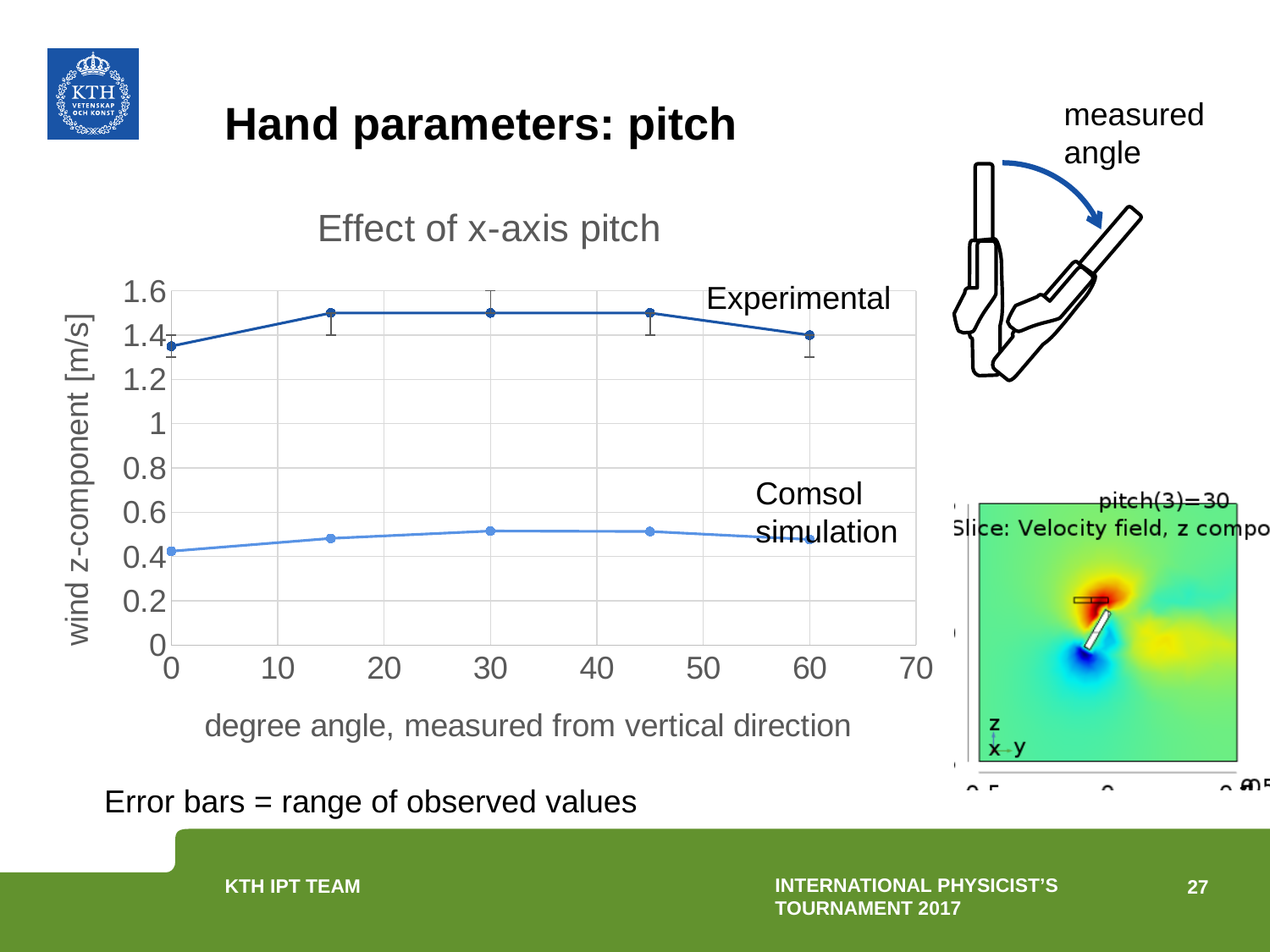
Is the Comsol simulation value at 30 degrees greater or less than 0.6? less Is the Experimental value at 30 degrees greater or less than 1.4? greater What kind of chart is shown on the slide? line chart At 30 degrees, which series has the larger value, Experimental or Comsol simulation? Experimental Does the Comsol simulation series rise or fall between 0 and 30 degrees? rise What is the label of the y axis of the chart? wind z-component [m/s] Is the Experimental value at 0 degrees greater or less than 1.2? greater How many data points does the Experimental series have? 5 How many data series are plotted in the chart? 2 At which angle is the Comsol simulation value lowest? 0 What is the title of the chart? Effect of x-axis pitch